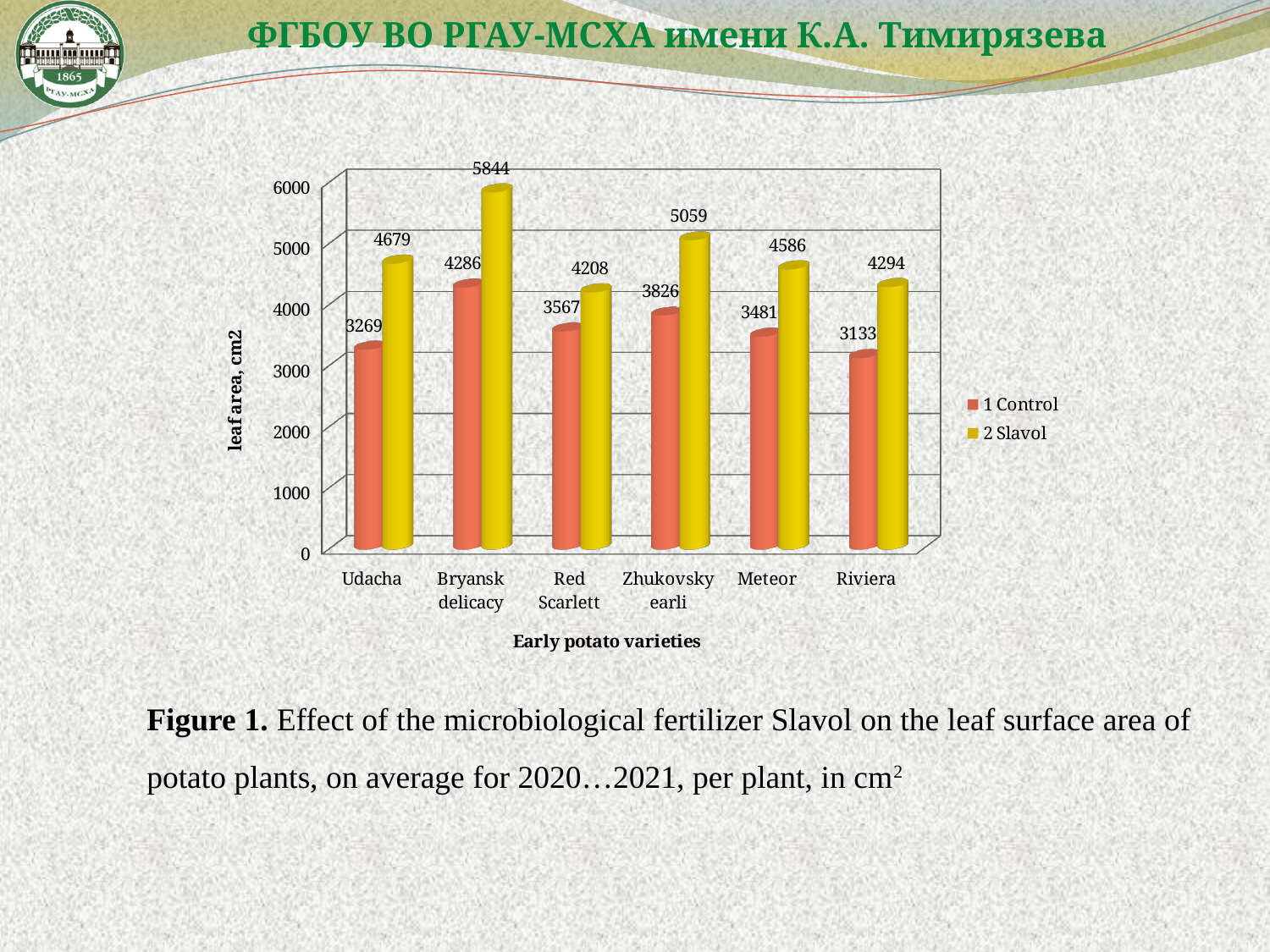
What is the leaf area for the Control series for Udacha? 3269 What is the label of the y axis? leaf area, cm2 Which is larger, the Slavol value for Meteor or the Slavol value for Riviera? Meteor Is the Control value for Bryansk delicacy greater or less than 4000? greater What kind of chart is shown on the slide? bar chart How many potato varieties are shown on the x axis? 6 How many series does the legend list? 2 What is the leaf area for the Control series for Riviera? 3133 Which variety has the lowest Control leaf area? Riviera Which variety has the highest Slavol leaf area? Bryansk delicacy What is the difference between the Slavol and Control leaf area for Zhukovsky earli? 1233 What is the leaf area for the Slavol series for Bryansk delicacy? 5844